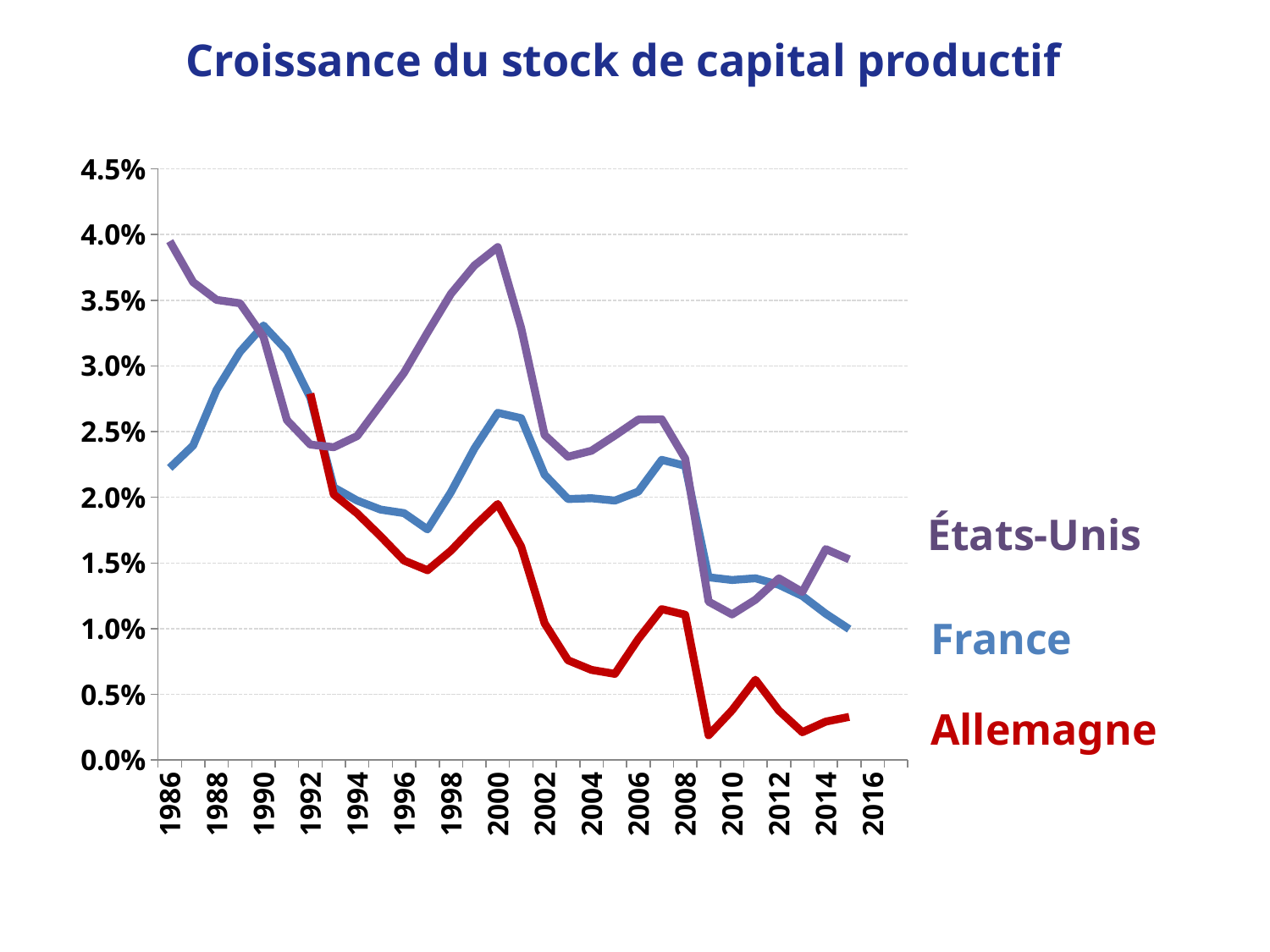
Does the Allemagne line generally rise or fall from 1992 to 2015? fall Which colour is used for the Allemagne line? red In 2009, which series has the higher value, France or Allemagne? France Is the value for France in 2015 greater or less than 1.5%? less Which series has the lowest value in 2015? Allemagne In 2000, which series has the higher value, États-Unis or France? États-Unis How many series are plotted on the chart? 3 What kind of chart is shown on the slide? line chart What is the title of the chart? Croissance du stock de capital productif Is the value for États-Unis in 2000 greater or less than 3.5%? greater Is the value for Allemagne in 2009 greater or less than 0.5%? less